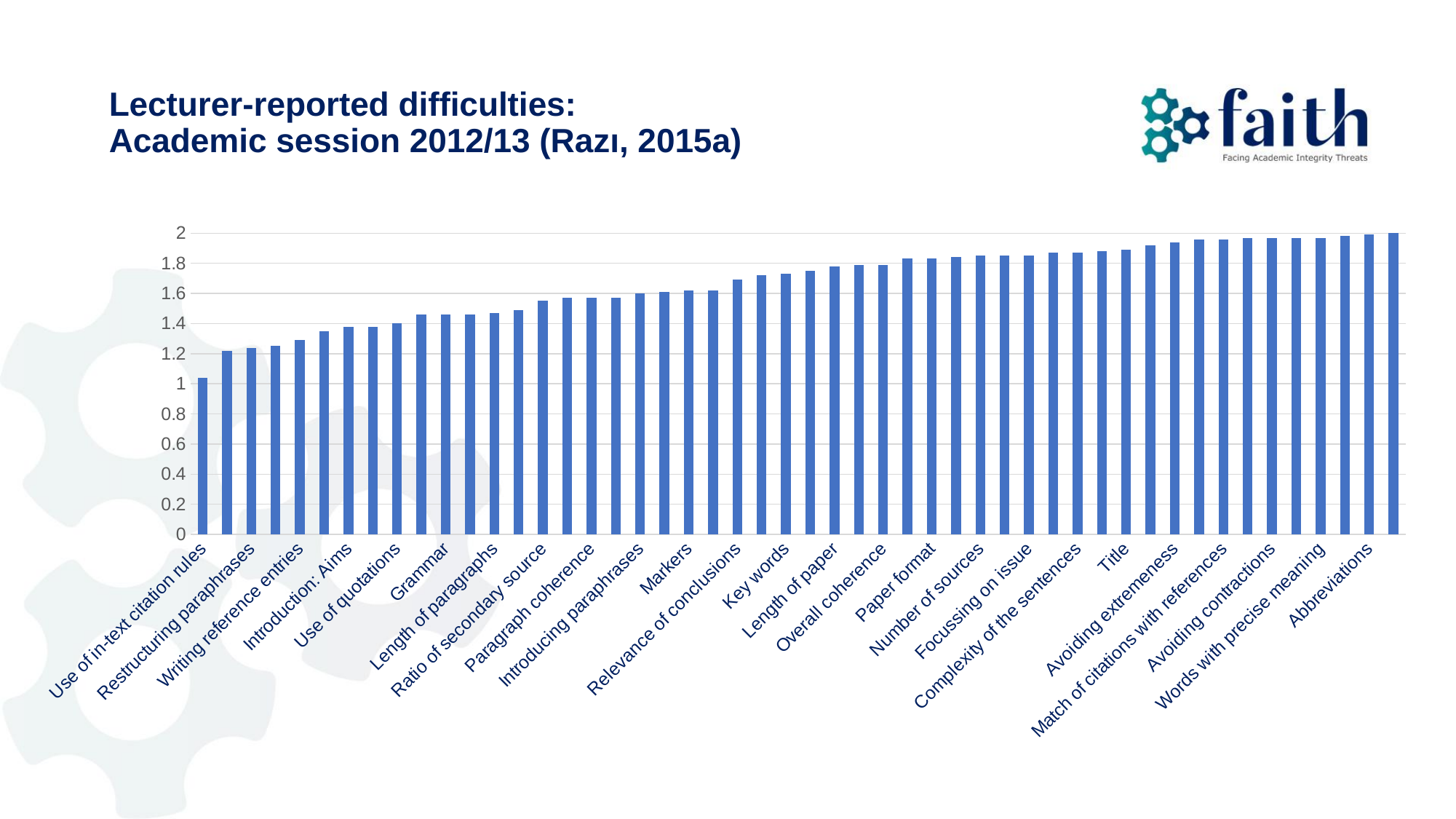
Is the value for Introduction: Aims greater or less than 1.6? less Which has the larger value, Grammar or Key words? Key words Which labelled category has the lowest value? Use of in-text citation rules Which has the larger value, Title or Introduction: Aims? Title Is the value for Key words greater or less than 1.6? greater Is the value for Markers greater or less than 1.4? greater What is the title of the slide containing the chart? Lecturer-reported difficulties: Academic session 2012/13 (Razı, 2015a) What kind of chart is shown on the slide? bar chart Do the bar values rise or fall from left to right across the chart? rise